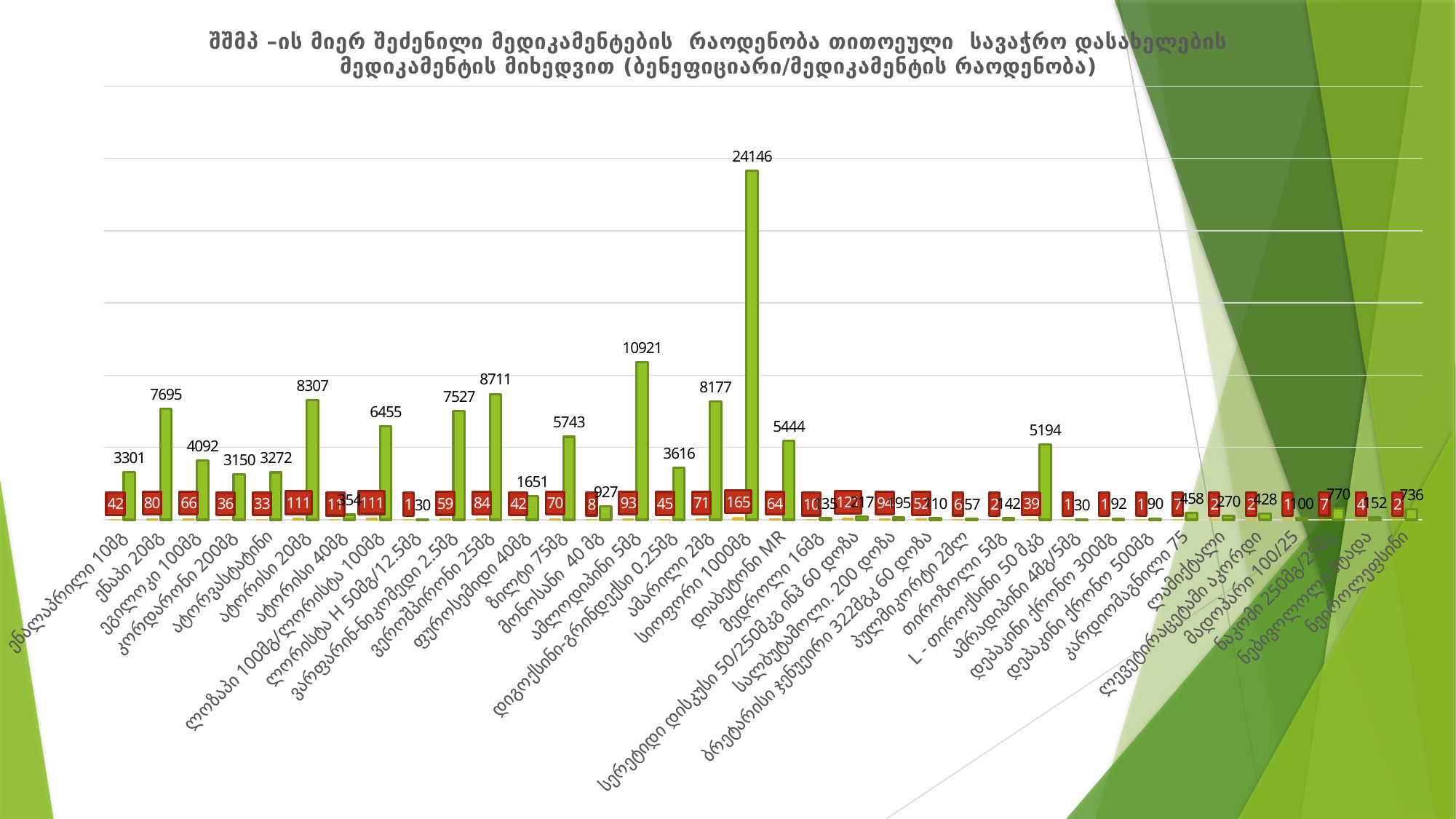
What is the medication count for ენაპი 20მგ? 7695 What is the medication count for L - თიროქსინი 50 მკგ? 5194 What is the medication count for ვეროშპირონი 25მგ? 8711 What is the medication count for ამლოდიპინი 5მგ? 10921 Which category has the highest medication count (green bar)? სიოფორი 1000მგ Which has a larger medication count, ენაპი 20მგ or ატორისი 20მგ? ატორისი 20მგ What kind of chart is shown on the slide? bar chart What is the beneficiary number (red label) for სიოფორი 1000მგ? 165 What is the beneficiary number (red label) for ატორისი 20მგ? 111 What is the difference between the medication counts for სიოფორი 1000მგ and ამლოდიპინი 5მგ? 13225 What is the medication count for სიოფორი 1000მგ? 24146